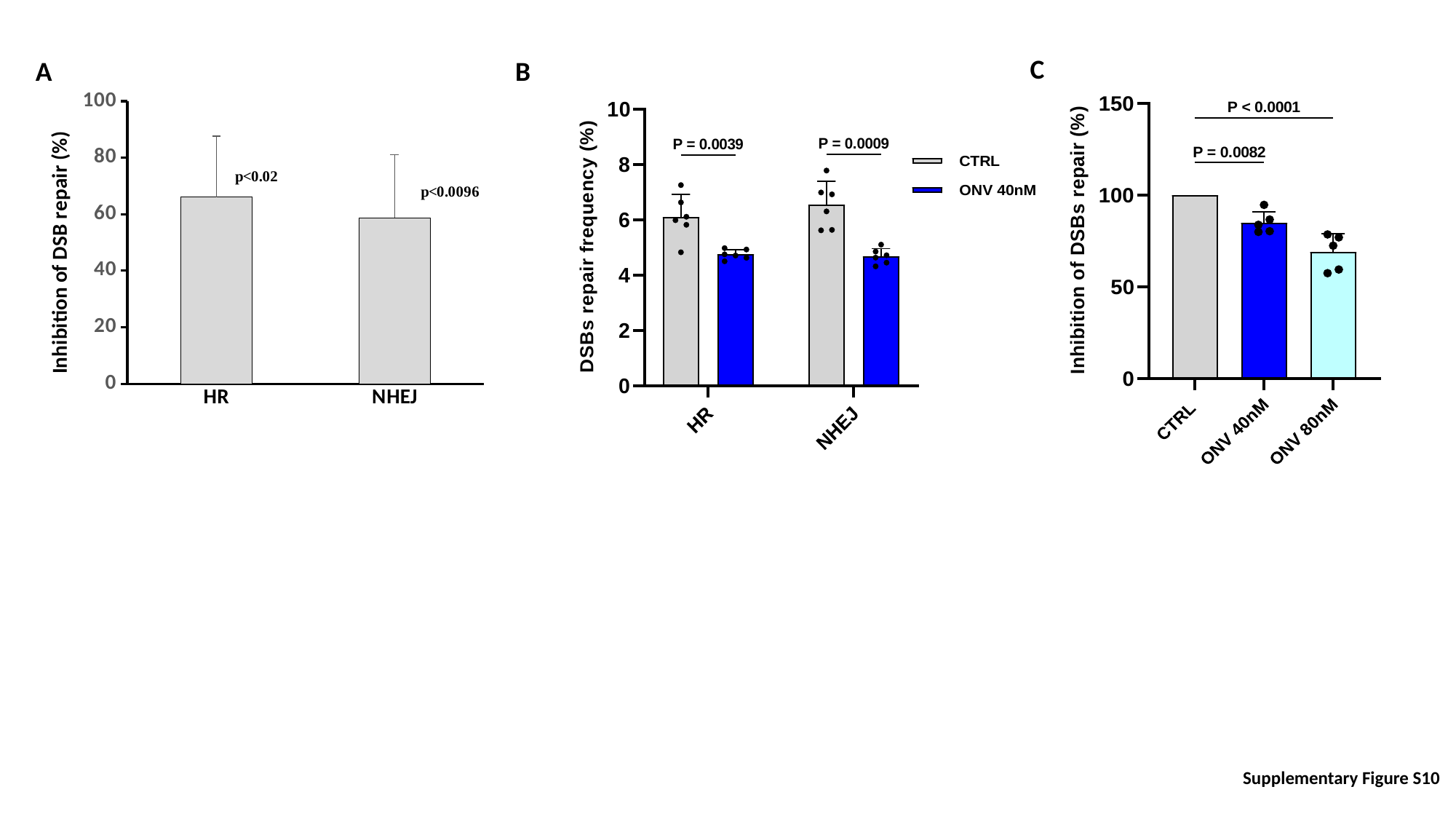
In chart B, is the ONV 40nM value for HR greater or less than 6? less In chart C, do the values rise or fall from CTRL to ONV 80nM along the x axis? fall In chart A, what p-value is printed next to the HR bar? p<0.02 In chart A, which category has the higher inhibition of DSB repair, HR or NHEJ? HR In chart A, is the value for HR greater or less than 60? greater In chart C, which category has the lowest inhibition of DSBs repair? ONV 80nM In chart B, what P value is printed above the HR bars? P = 0.0039 In chart A, how many categories are shown on the x axis? 2 In chart C, what is the value for CTRL? 100 In chart B, how many series does the legend list? 2 In chart B, for HR, which is larger: CTRL or ONV 40nM? CTRL In chart B, is the CTRL value for NHEJ greater or less than 6? greater